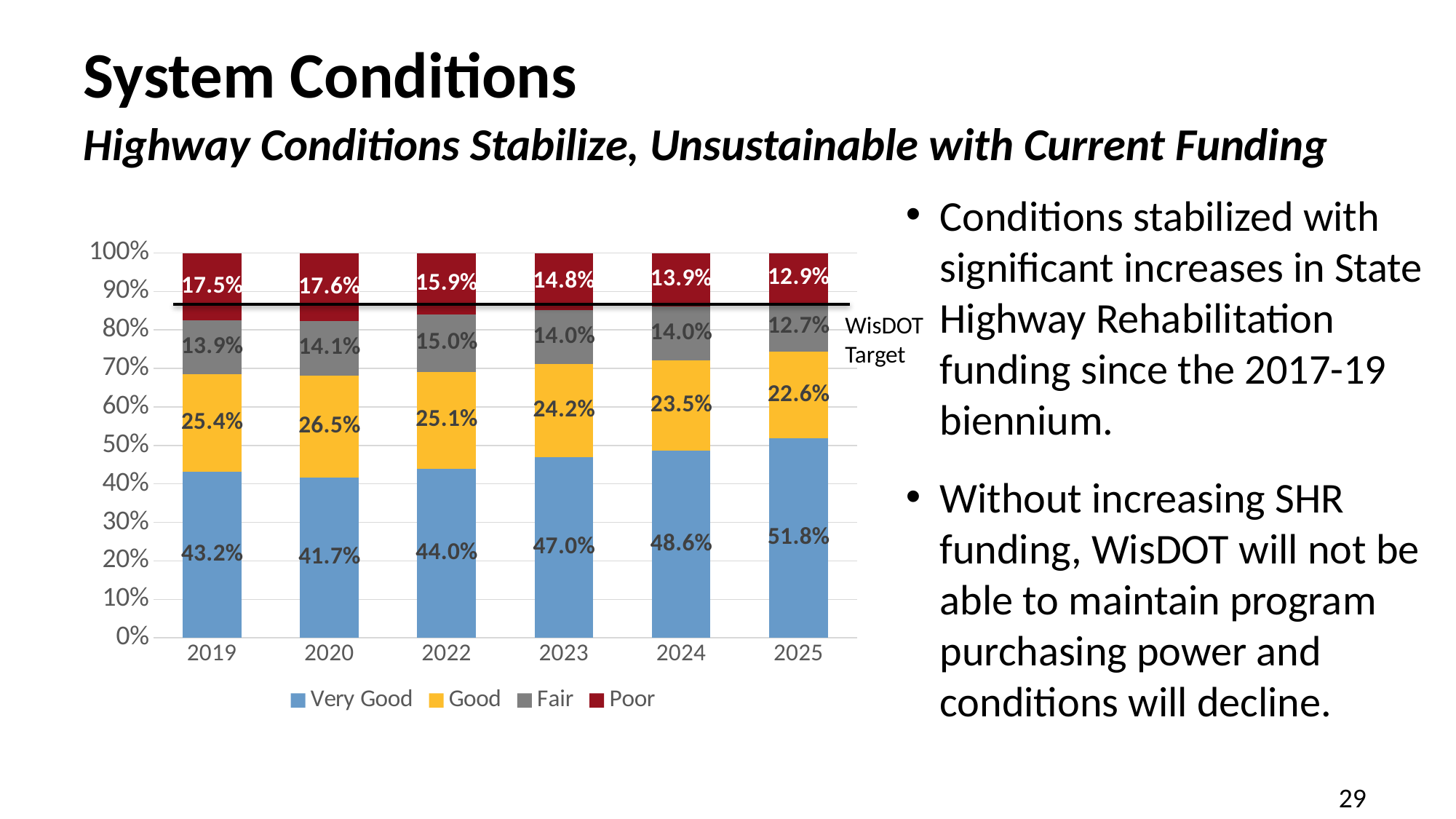
What is the Poor share shown for 2019? 17.5% What percentage of highways were in Very Good condition in 2025? 51.8% In which year is the Poor share the lowest? 2025 In which year is the Very Good share the highest? 2025 What value is shown for the Fair category in 2022? 15.0% How many years are shown on the x axis of the chart? 6 What kind of chart is shown on the slide? Stacked bar chart Does the Poor share rise or fall from 2020 to 2025? Fall How many series does the chart legend list? 4 In 2019, which is larger: the Good share or the Fair share? Good What is the Good share for 2020? 26.5% By how many percentage points did the Very Good share increase from 2019 to 2025? 8.6 percentage points